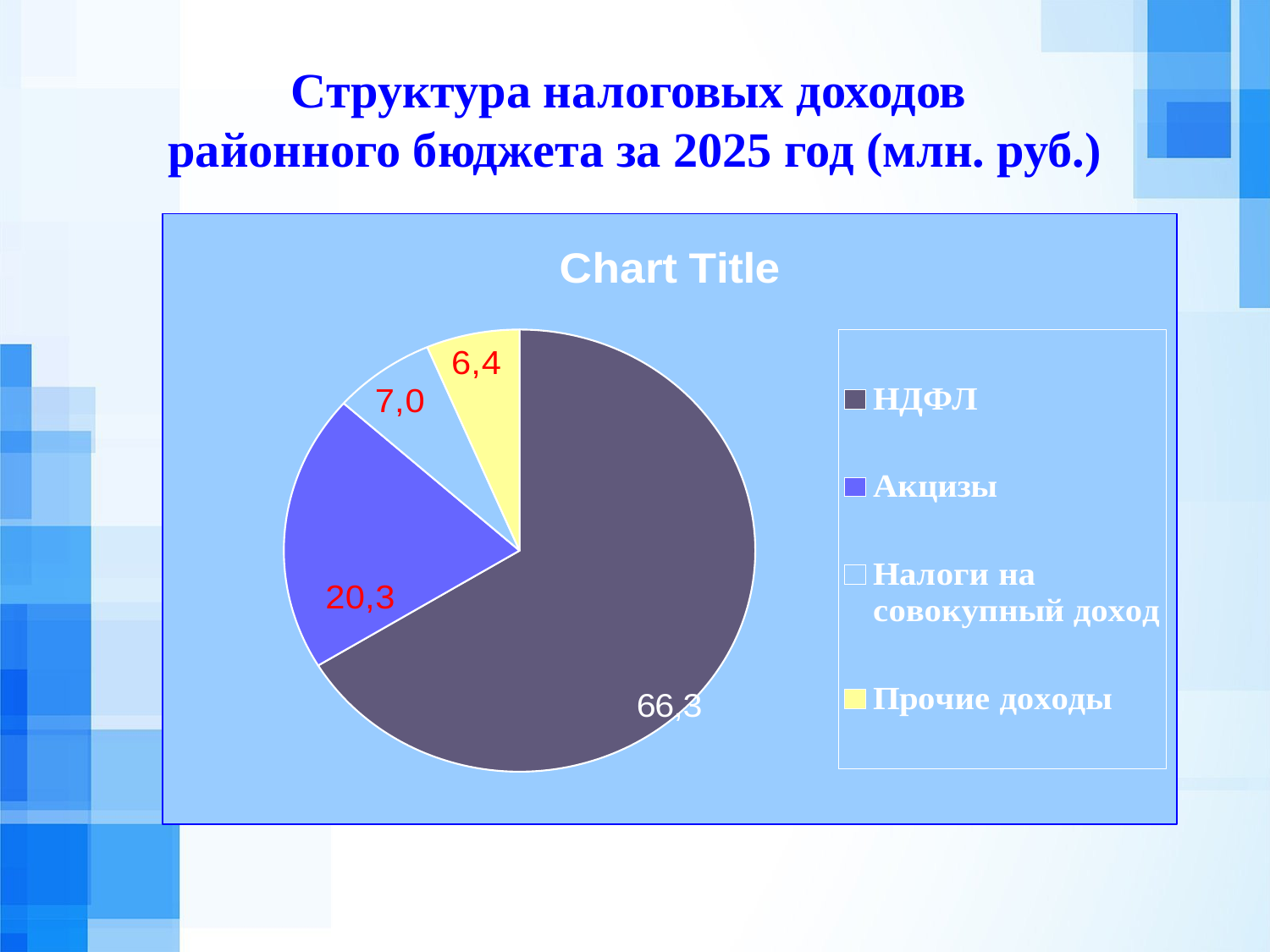
What is the value for Прочие доходы? 6,4 What is the difference between the values for НДФЛ and Акцизы? 46,0 What type of chart is shown on the slide? pie chart What is the value for НДФЛ? 66,3 Which is larger, the value for Акцизы or the value for Налоги на совокупный доход? Акцизы How many entries does the legend list? 4 What is the total of all the slice values in the pie chart? 100,0 What is the value for Акцизы? 20,3 Which category has the smallest slice of the pie? Прочие доходы What is the value for Налоги на совокупный доход? 7,0 Which category has the largest slice of the pie? НДФЛ How many slices does the pie chart have? 4